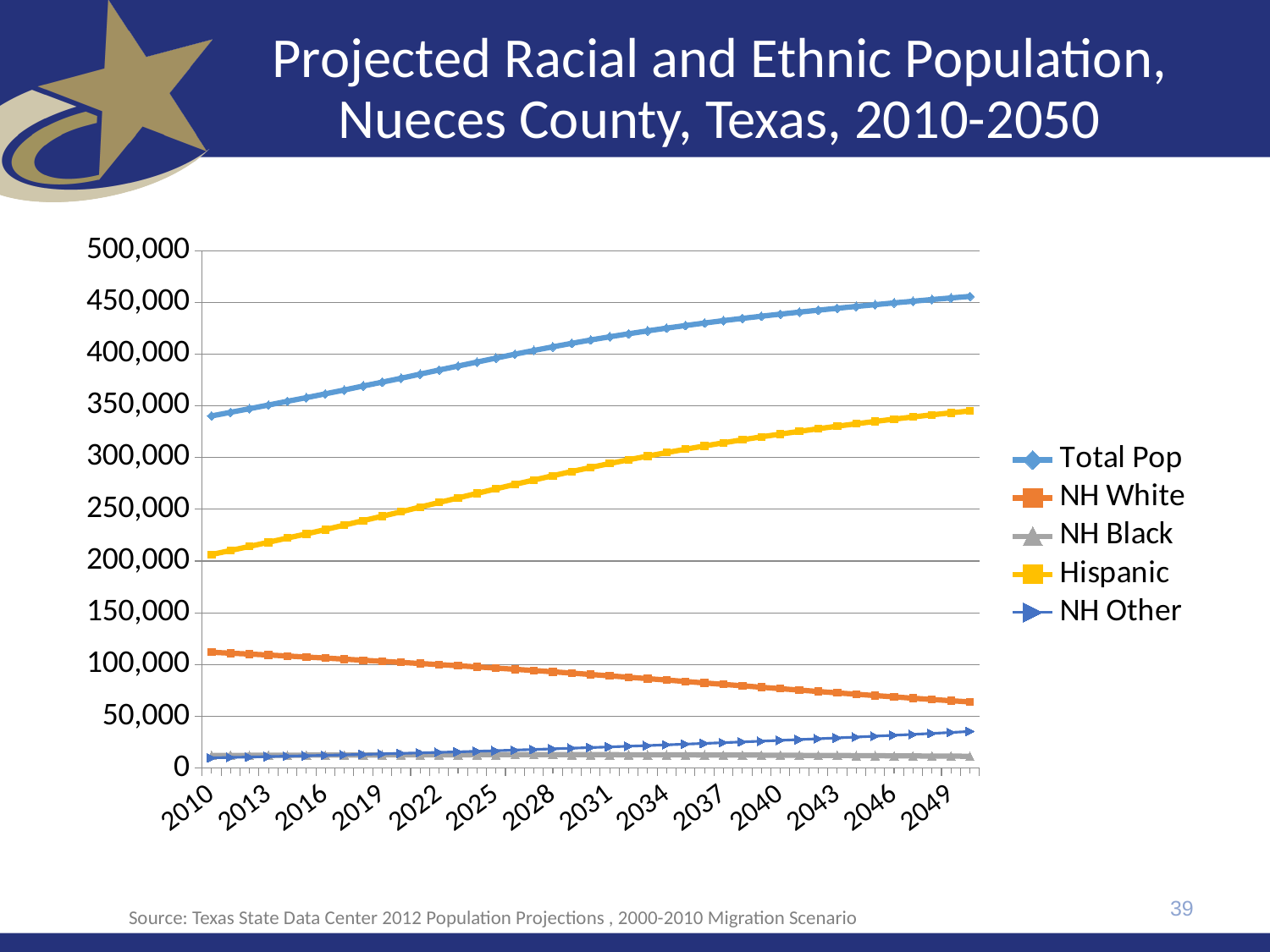
Is the Hispanic value in 2049 greater or less than 300,000? greater What is the title of the chart on the slide? Projected Racial and Ethnic Population, Nueces County, Texas, 2010-2050 Does the Hispanic series rise or fall from 2010 to 2050? rise Is the Total Pop value in 2049 greater or less than 500,000? less How many series does the legend list? 5 What kind of chart is shown on the slide? line chart Which series has the lowest value in 2049? NH Black Does the NH White series rise or fall from 2010 to 2050? fall Is the NH White value in 2049 greater or less than 100,000? less In 2010, which is larger, the Hispanic value or the NH White value? Hispanic Which series has the highest values throughout the chart? Total Pop